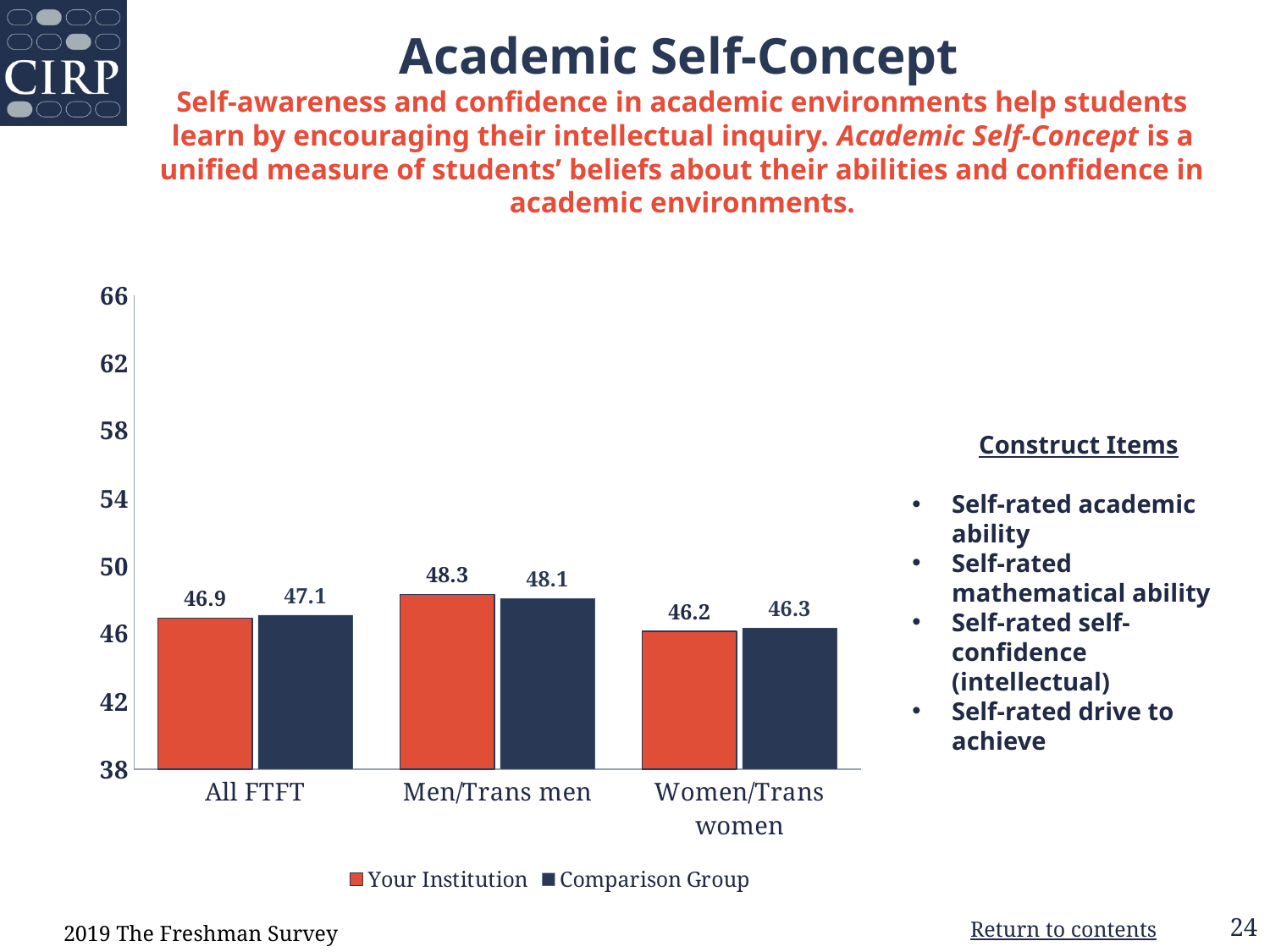
How many categories are shown on the x axis? 3 What is the value for Comparison Group in the Men/Trans men category? 48.1 Which category has the highest value for Your Institution? Men/Trans men What is the value for Your Institution in the Women/Trans women category? 46.2 What is the value for Comparison Group in the Women/Trans women category? 46.3 Which is larger for All FTFT: Your Institution or Comparison Group? Comparison Group What is the value for Your Institution in the All FTFT category? 46.9 Which category has the lowest value for Comparison Group? Women/Trans women How many series does the legend list? 2 What is the difference between the Your Institution values for Men/Trans men and Women/Trans women? 2.1 What kind of chart is shown on the slide? Bar chart What is the difference between the Your Institution and Comparison Group values for Men/Trans men? 0.2